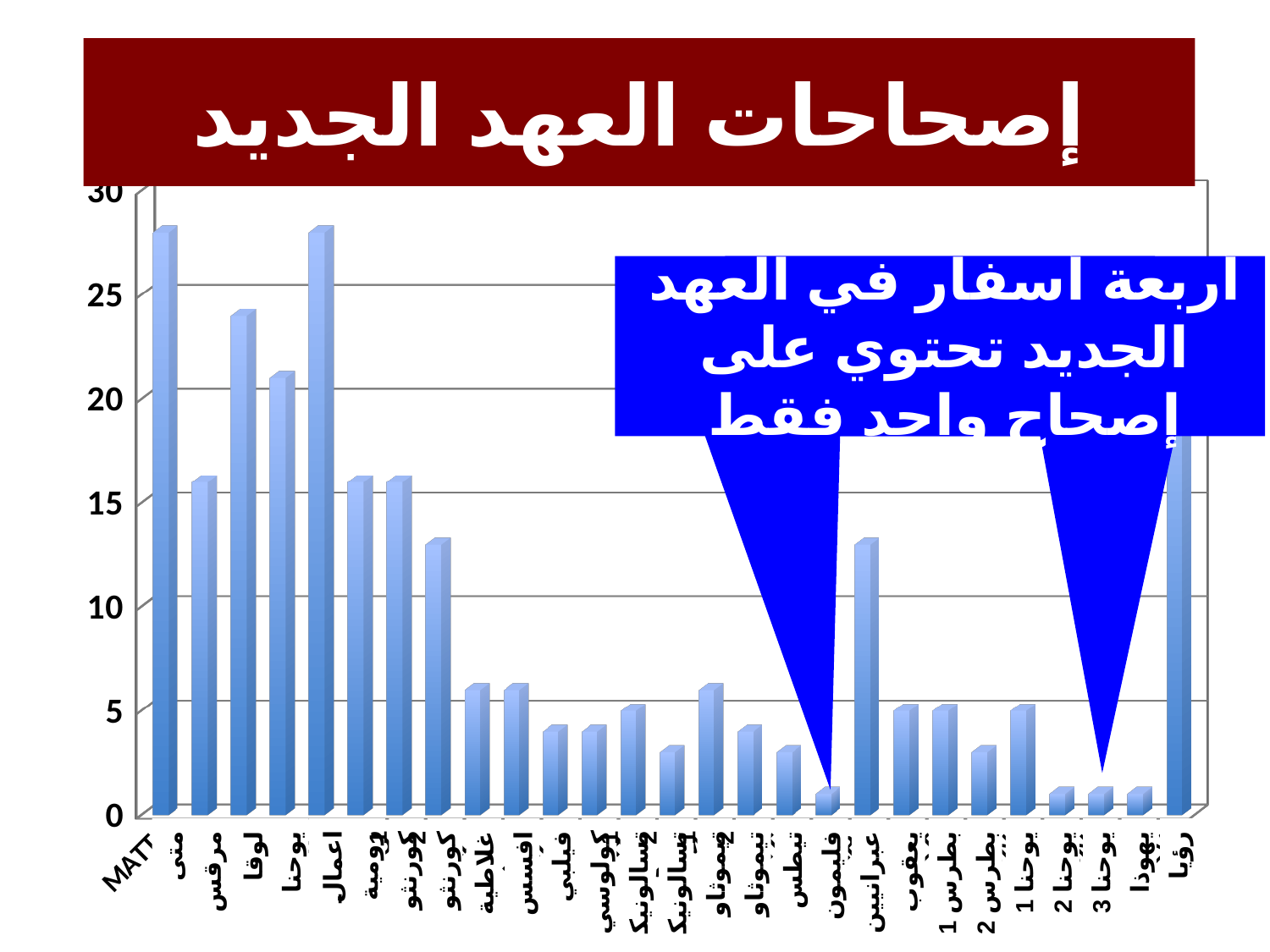
Is the value for متى greater or less than 25? greater Which has the larger value, رؤيا or عبرانيين? رؤيا What kind of chart is shown on the slide? bar chart What is the title of the chart on the slide? إصحاحات العهد الجديد Which has the larger value, عبرانيين or يعقوب? عبرانيين Which has the larger value, لوقا or مرقس? لوقا Is the value for 2تسالونيك greater or less than 5? less Is the value for لوقا greater or less than 20? greater What is the highest value shown on the vertical axis of the chart? 30